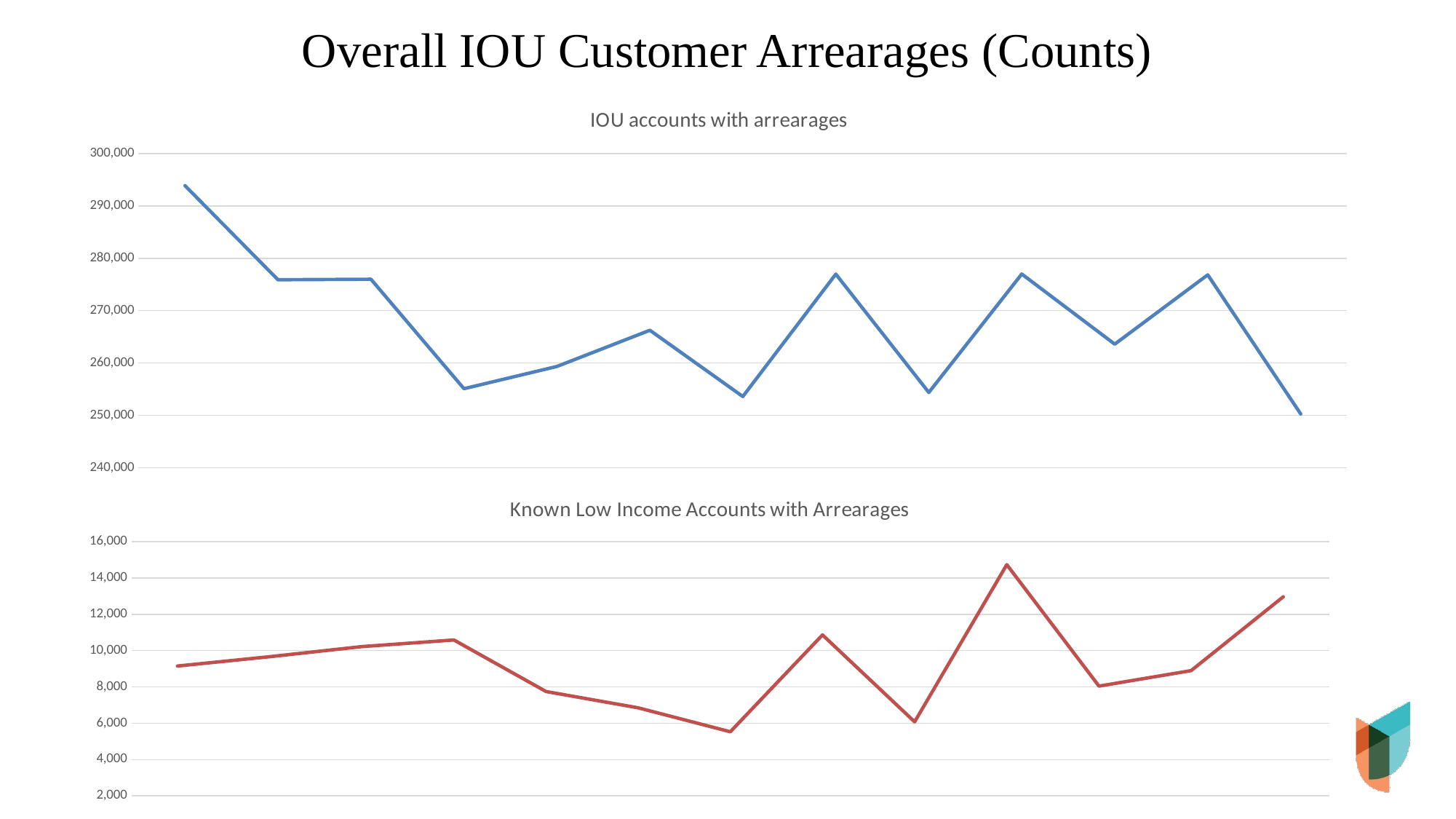
In the 'Known Low Income Accounts with Arrearages' chart, is the last plotted value greater or less than 12,000? greater In the 'IOU accounts with arrearages' chart, is the lowest plotted value greater or less than 260,000? less In the 'IOU accounts with arrearages' chart, is the last plotted value higher or lower than the first plotted value? lower In the 'Known Low Income Accounts with Arrearages' chart, is the lowest plotted value greater or less than 6,000? less What is the title of the upper chart on the slide? IOU accounts with arrearages In the 'IOU accounts with arrearages' chart, does the line overall rise or fall from left to right? fall What colour is the line in the 'Known Low Income Accounts with Arrearages' chart? red What kind of chart is the 'IOU accounts with arrearages' chart? line chart In the 'Known Low Income Accounts with Arrearages' chart, is the last plotted value higher or lower than the first plotted value? higher What kind of chart is the 'Known Low Income Accounts with Arrearages' chart? line chart